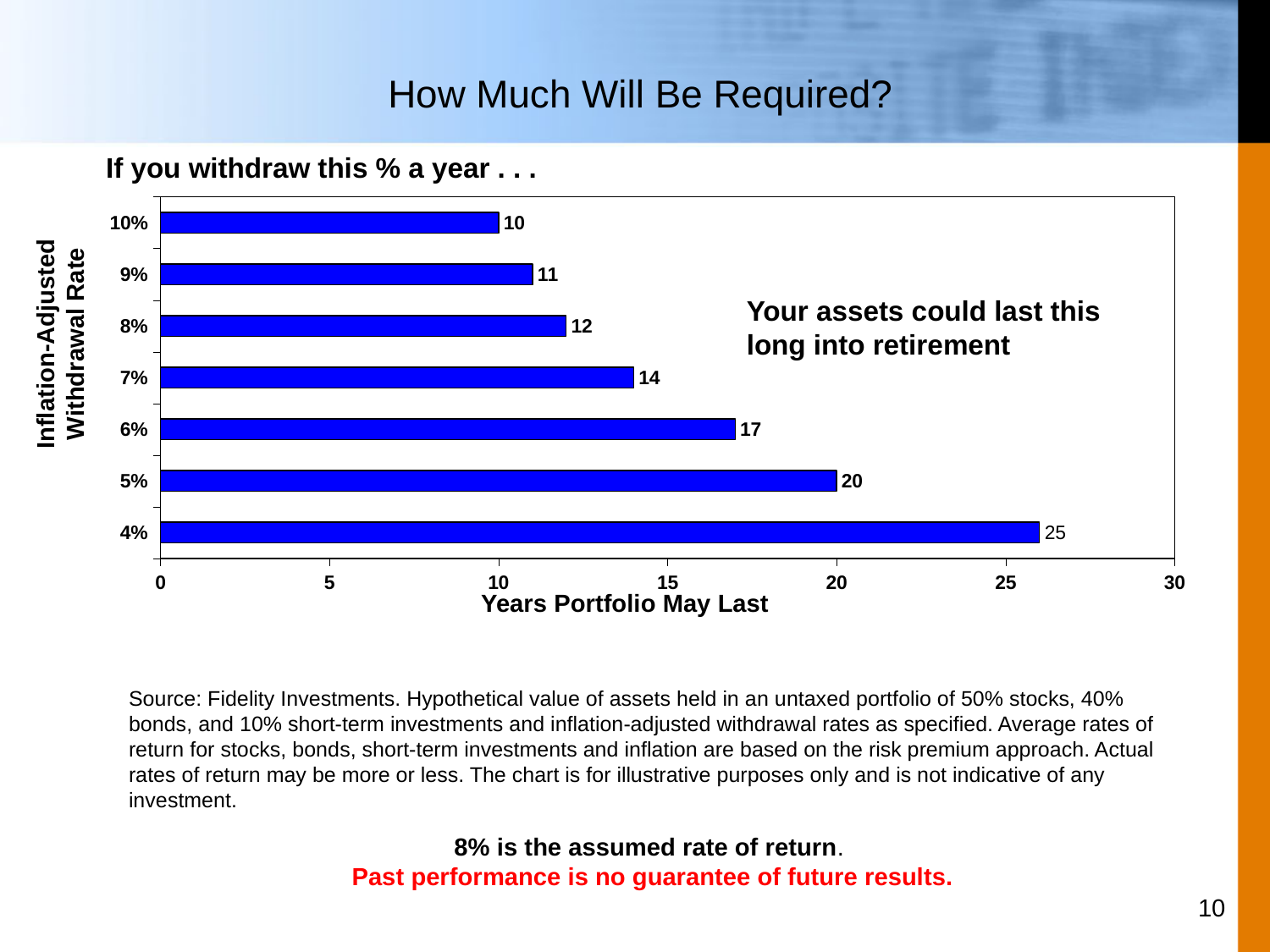
What is the difference in years between the 5% and 8% withdrawal rates? 8 Which lasts longer, the portfolio at a 6% withdrawal rate or at an 8% withdrawal rate? 6% What kind of chart is shown on the slide? bar chart What is the value shown for the 9% withdrawal rate? 11 Which withdrawal rate has the lowest number of years the portfolio may last? 10% How many years may the portfolio last at a 7% withdrawal rate? 14 How many withdrawal rate categories are shown in the chart? 7 Is the value for the 6% withdrawal rate greater or less than 15? greater Do the years the portfolio may last rise or fall as the withdrawal rate increases from 4% to 10%? fall What is the label of the horizontal axis of the chart? Years Portfolio May Last Which withdrawal rate has the highest number of years the portfolio may last? 4% How many years may the portfolio last at a 4% inflation-adjusted withdrawal rate? 25